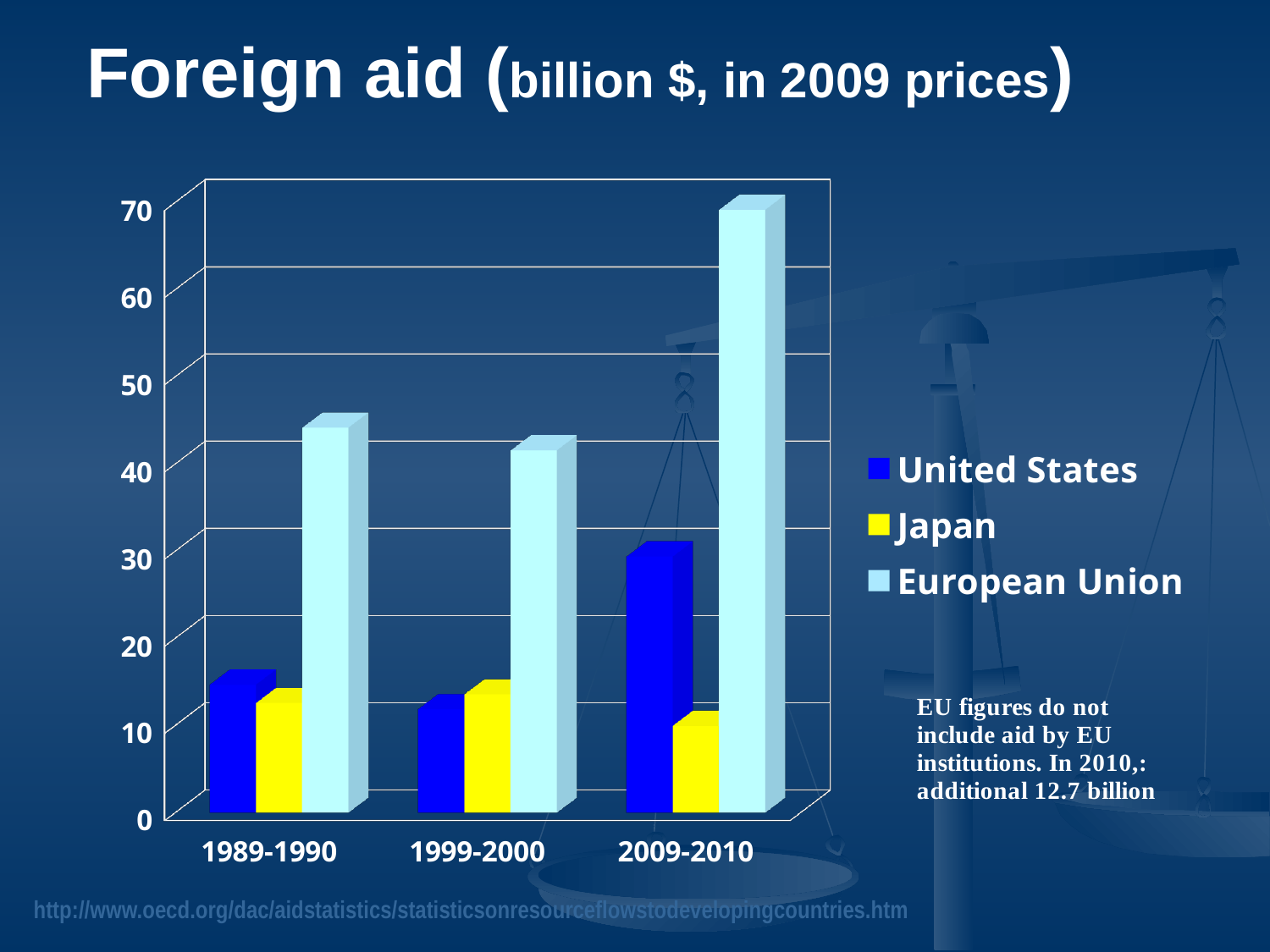
Is the Japan value for 2009-2010 greater or less than 20? less How many series does the legend list? 3 How many time periods are shown on the x axis? 3 In which period is the European Union value highest? 2009-2010 Is the European Union value for 1999-2000 greater or less than 50? less Is the United States value for 2009-2010 greater or less than 20? greater In 2009-2010, which is larger: the United States value or the Japan value? United States Does the European Union value rise or fall from 1999-2000 to 2009-2010? rise What kind of chart is shown on the slide? bar chart Which series has the highest value in 2009-2010? European Union Which series has the lowest value in 2009-2010? Japan